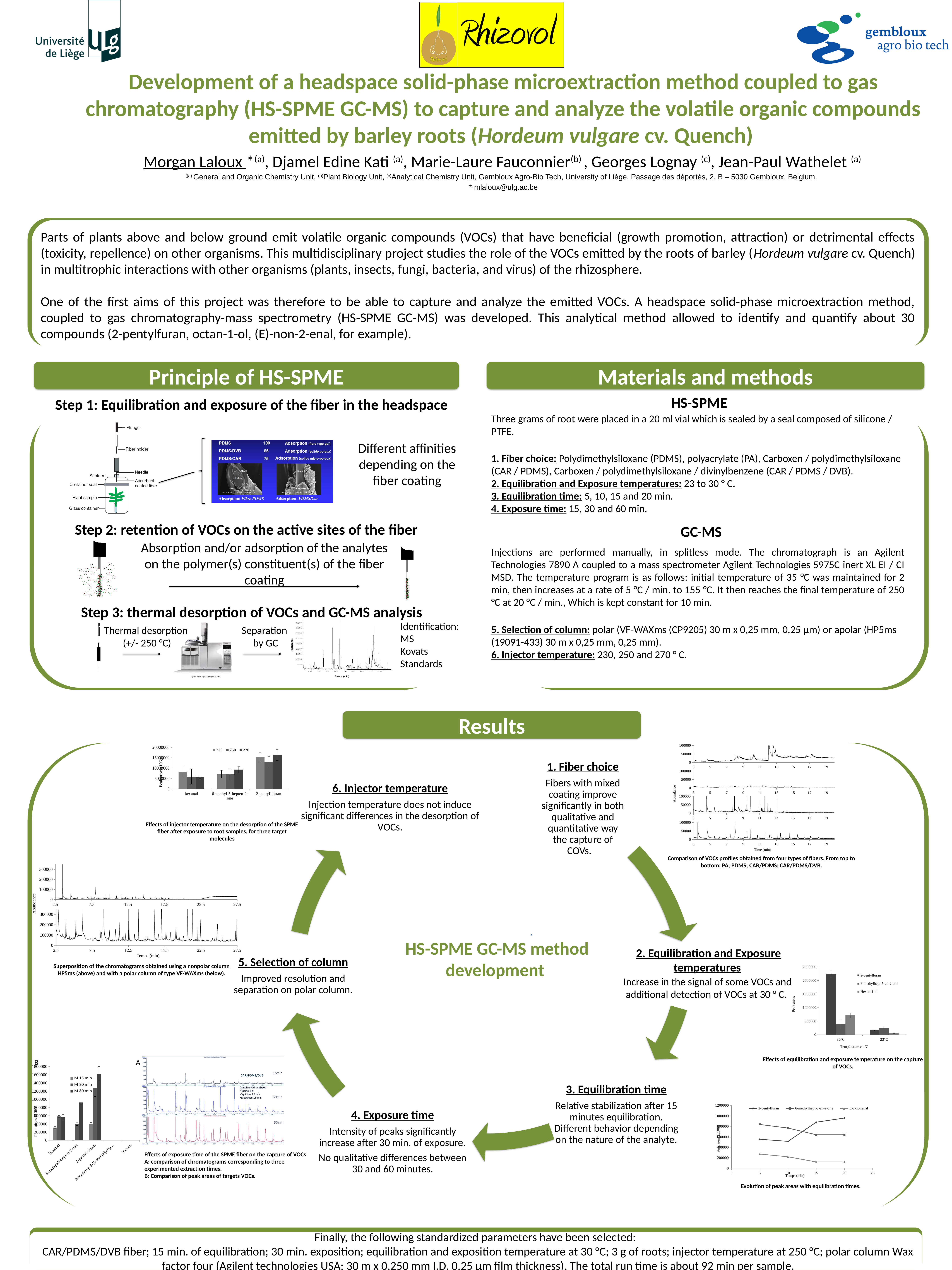
On the equilibration time chart (bottom right of the Results section), what is the label of the x axis? Temps (min) On the equilibration and exposure temperature chart (right side of the Results section), which temperature gives the larger value for 2-pentylfuran, 30°C or 23°C? 30°C On the equilibration time chart (bottom right of the Results section), which series has the lowest peak areas? E-2-nonenal On the exposure time bar chart (chart B, bottom left of the Results section), is the value for hexanal at M 15 min greater or less than 400000? less On the exposure time bar chart (chart B, bottom left of the Results section), how many series does the legend list? 3 On the equilibration time chart (bottom right of the Results section), what kind of chart is it? line chart On the injector temperature chart (top left of the Results section), is the value for hexanal at 230 greater or less than 10000000? less On the injector temperature chart (top left of the Results section), how many series does the legend list? 3 On the injector temperature chart (top left of the Results section), which compound has the highest peak areas? 2-pentyl-furan On the equilibration and exposure temperature chart (right side of the Results section), is the value for 2-pentylfuran at 30°C greater or less than 2000000? greater On the injector temperature chart (top left of the Results section), what kind of chart is it? bar chart On the equilibration and exposure temperature chart (right side of the Results section), how many series does the legend list? 3